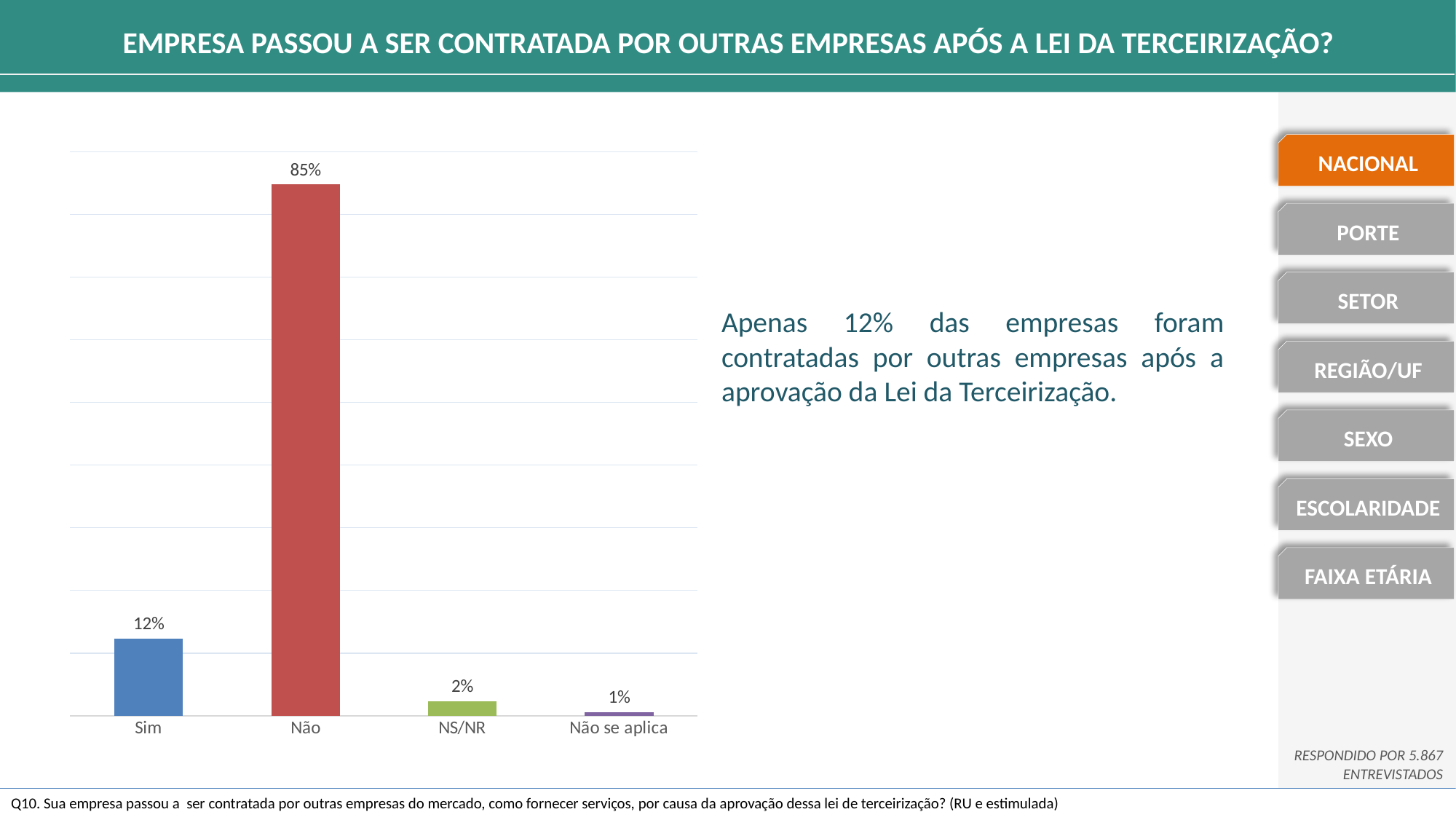
What is the value for "Sim"? 12% What is the value for "Não"? 85% What is the value for "NS/NR"? 2% What is the difference between the values for "NS/NR" and "Não se aplica"? 1% What is the difference between the values for "Não" and "Sim"? 73% What is the value for "Não se aplica"? 1% What kind of chart is shown on the slide? Bar chart Which category has the highest value? Não Which is larger, the value for "Sim" or the value for "NS/NR"? Sim How many categories are shown on the x axis? 4 Which category has the lowest value? Não se aplica What colour is the bar for "Não"? Red